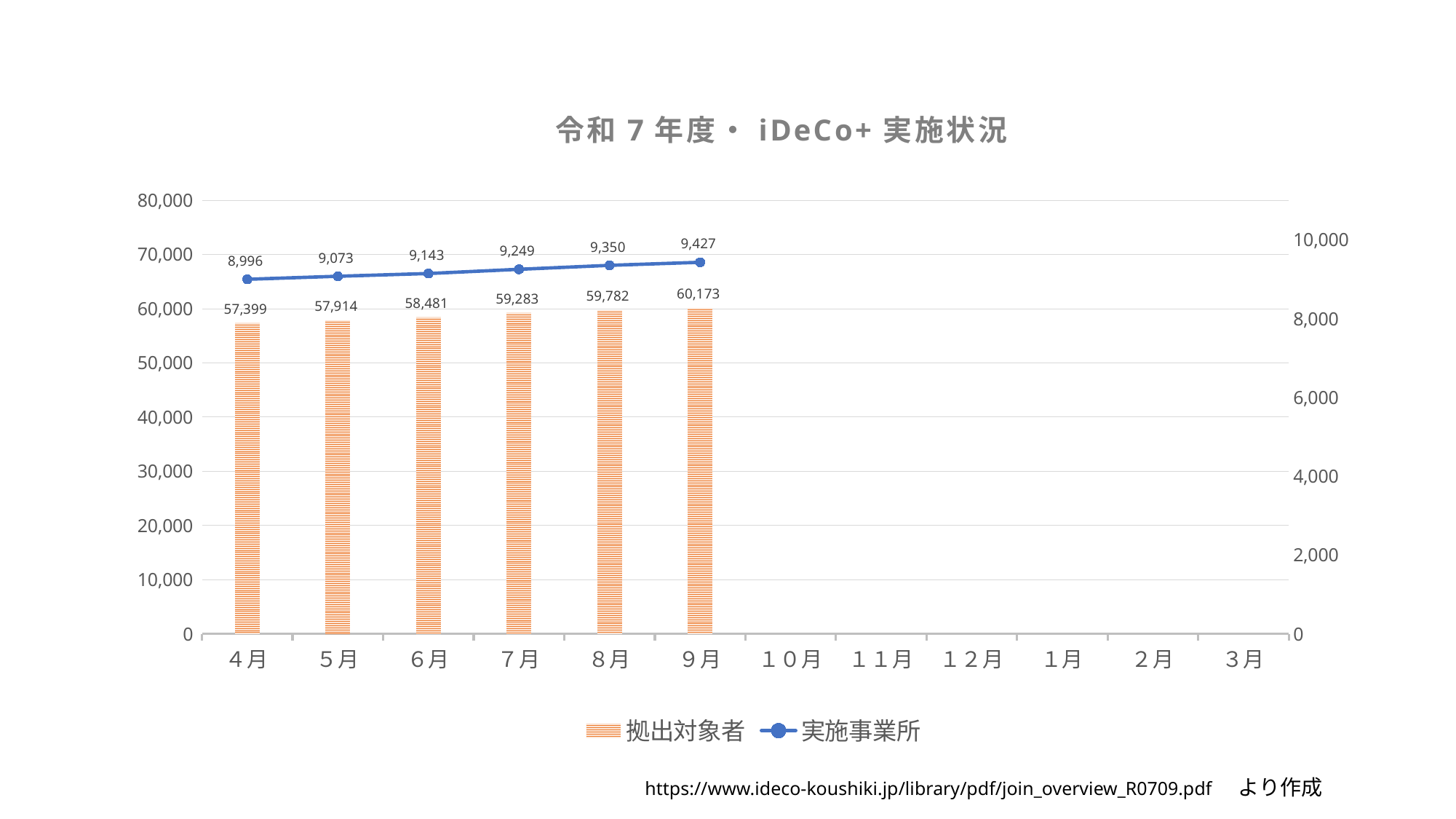
Which month has the lowest value for 実施事業所? 4月 How many series does the legend list? 2 What is the value of 実施事業所 for 6月? 9,143 Which month has the highest value for 拠出対象者? 9月 What is the difference between the 拠出対象者 values for 9月 and 4月? 2,774 What is the value of 拠出対象者 for 7月? 59,283 How many months have plotted data for 拠出対象者? 6 What is the value of 実施事業所 for 9月? 9,427 Do the 実施事業所 values rise or fall from 4月 to 9月? rise Which is larger, the 拠出対象者 value for 5月 or for 6月? 6月 What is the value of 拠出対象者 for 4月? 57,399 What is the difference between the 実施事業所 values for 8月 and 7月? 101